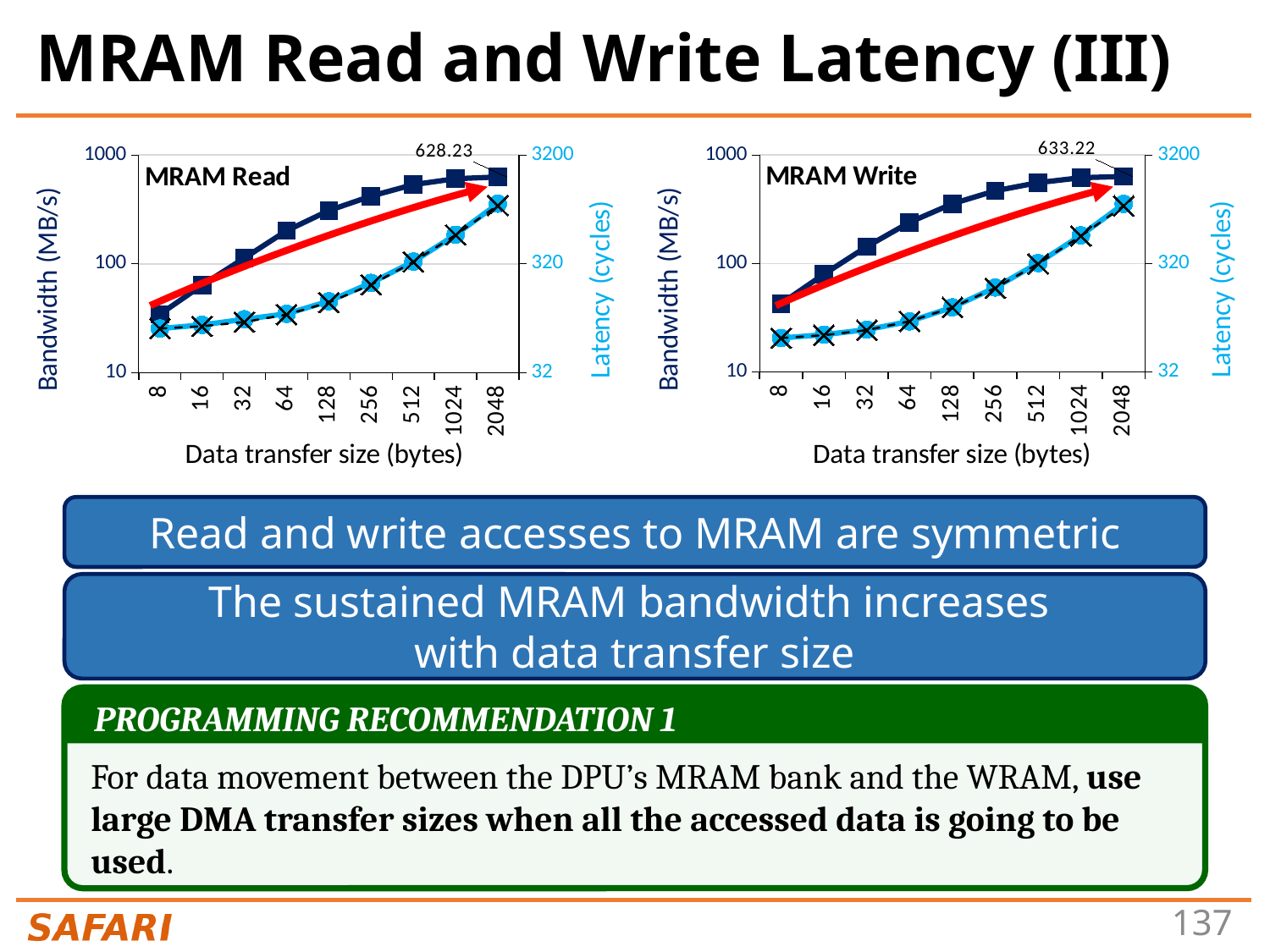
What is the label of the left vertical axis in the MRAM Read chart? Bandwidth (MB/s) In the MRAM Read chart, does the bandwidth rise or fall as the data transfer size increases? Rise In the MRAM Write chart, at which data transfer size is the bandwidth lowest? 8 Which is larger: the labelled bandwidth at 2048 bytes in the MRAM Read chart or in the MRAM Write chart? MRAM Write In the MRAM Write chart, is the bandwidth at a data transfer size of 64 bytes greater or less than 100 MB/s? greater In the MRAM Read chart, how many data transfer sizes are plotted along the x axis? 9 In the MRAM Read chart, is the bandwidth at a data transfer size of 512 bytes greater or less than 100 MB/s? greater In the MRAM Write chart, what is the bandwidth value labelled at a data transfer size of 2048 bytes? 633.22 In the MRAM Read chart, is the bandwidth at a data transfer size of 8 bytes greater or less than 100 MB/s? less What is the difference between the labelled bandwidth at 2048 bytes in the MRAM Write chart and in the MRAM Read chart? 4.99 In the MRAM Read chart, what is the bandwidth value labelled at a data transfer size of 2048 bytes? 628.23 What kind of chart is the MRAM Write chart? Line chart